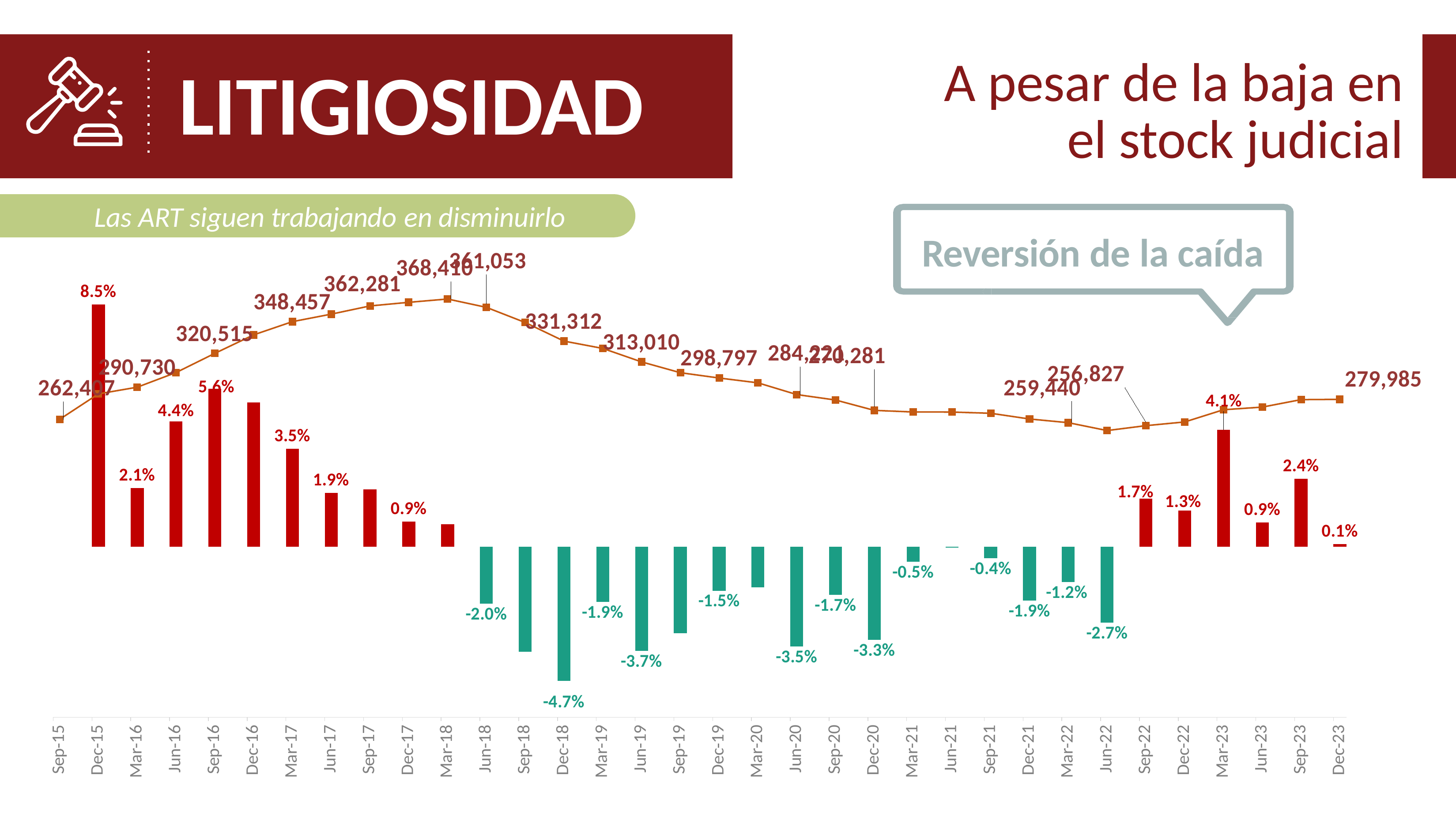
Which period has the lowest (most negative) percentage-change bar? Dec-18 How many periods are shown on the x axis? 34 What kind of chart is this? Combined bar and line chart Which period has the highest percentage-change bar? Dec-15 Does the line rise or fall from Sep-15 to Mar-18? Rise What is the stock judicial value shown for Dec-23 on the line? 279,985 What percentage change does the bar for Dec-18 show? -4.7% What percentage change does the bar for Dec-15 show? 8.5% What value does the line show for Mar-18? 368,410 Which bar is larger, Mar-23 or Sep-23? Mar-23